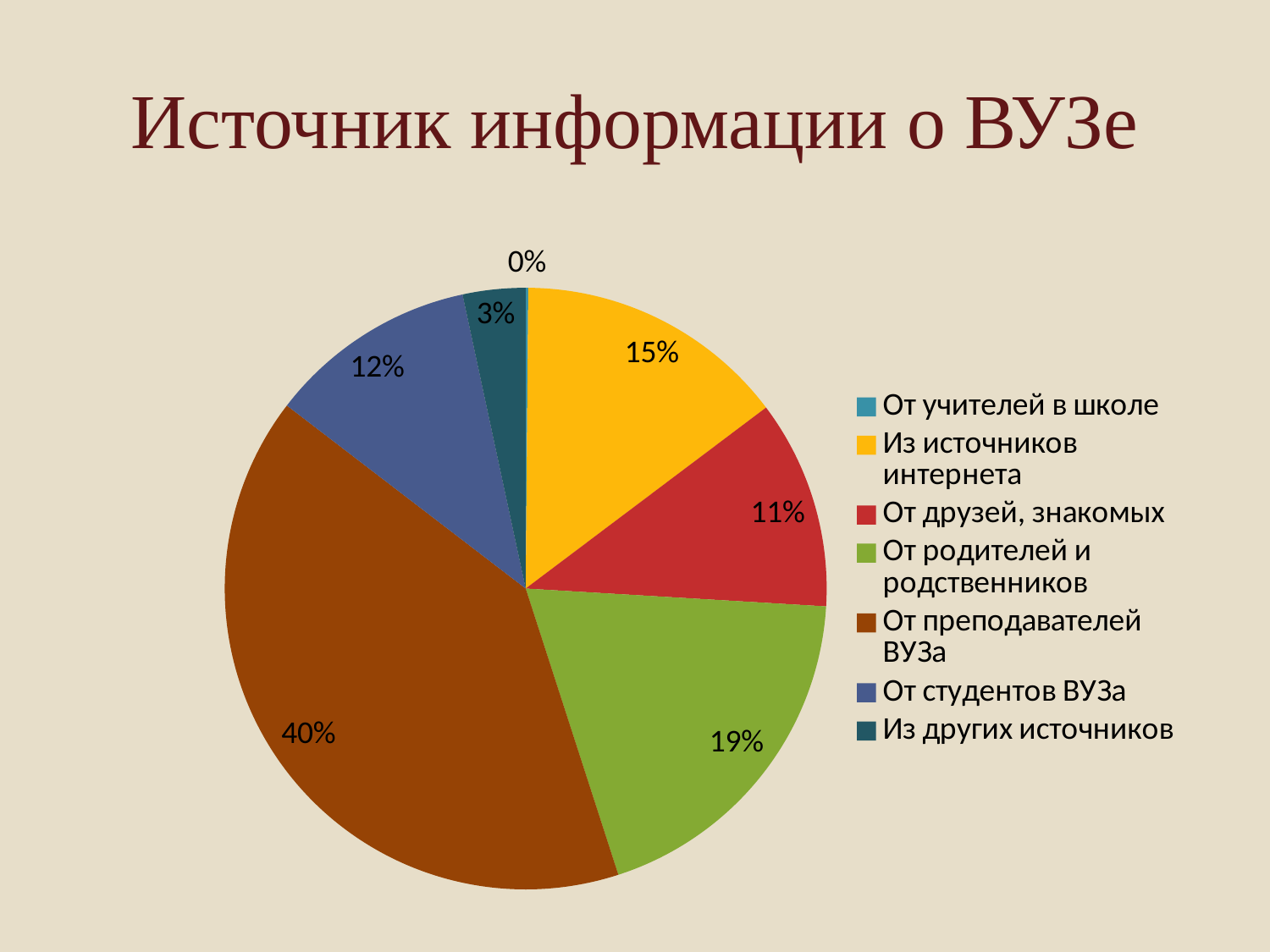
What colour is the slice for 'Из других источников'? dark teal Which category has the largest share of the pie? От преподавателей ВУЗа What type of chart is shown on the slide? pie chart What is the value for 'Из источников интернета'? 15% What is the difference between the shares for 'От преподавателей ВУЗа' and 'От родителей и родственников'? 21% What is the value for 'От учителей в школе'? 0% What is the title of the chart? Источник информации о ВУЗе How many categories does the legend list? 7 What share of the pie is 'От преподавателей ВУЗа'? 40% Which category has the smallest share of the pie? От учителей в школе Which is larger: the share for 'От студентов ВУЗа' or for 'От друзей, знакомых'? От студентов ВУЗа What is the value for 'От родителей и родственников'? 19%